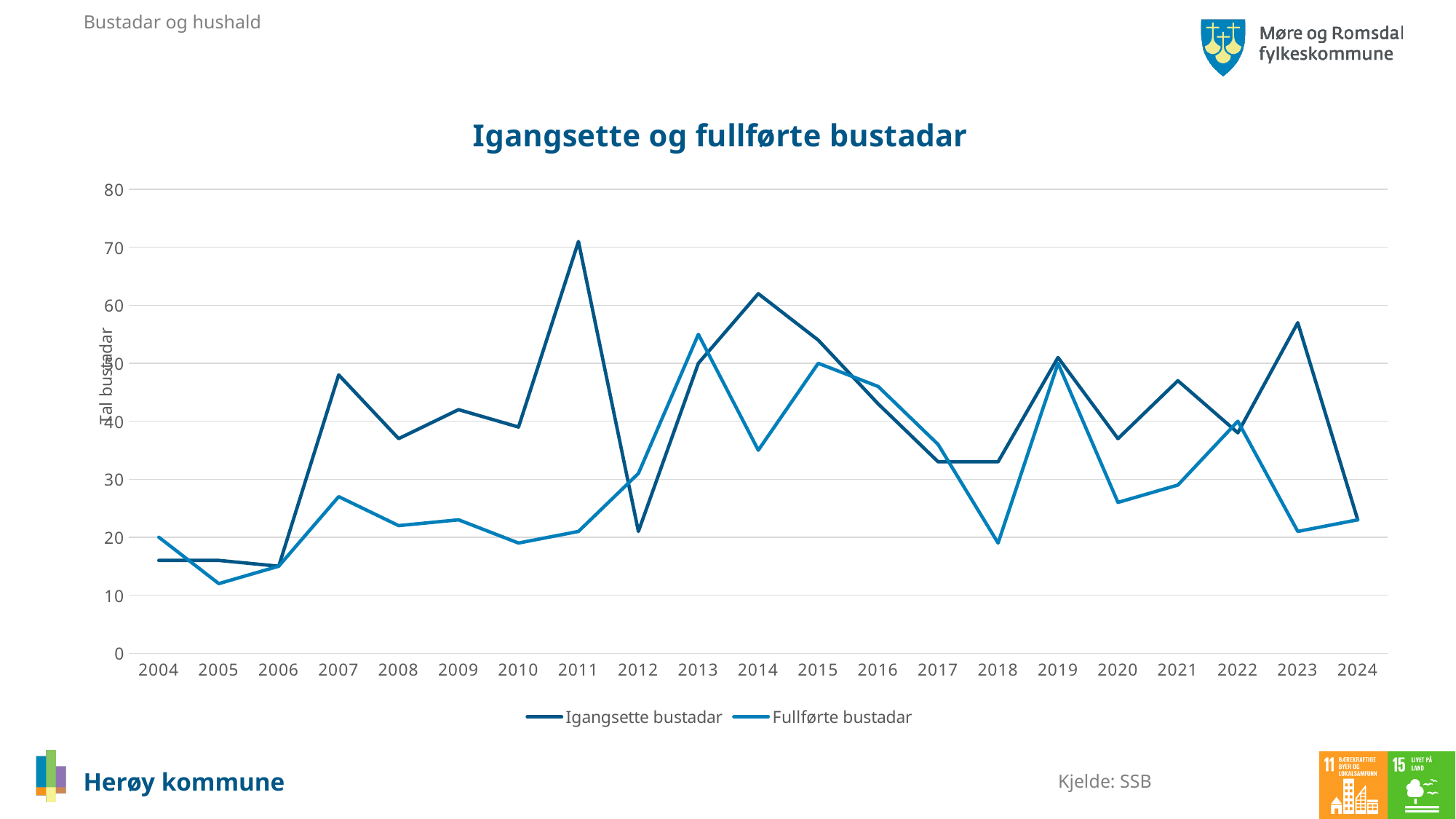
Is the value for Igangsette bustadar in 2012 greater or less than 30? less Is the value for Igangsette bustadar in 2011 greater or less than 60? greater In which year is the value for Fullførte bustadar lowest? 2005 In which year is the value for Igangsette bustadar highest? 2011 Does the value for Igangsette bustadar rise or fall from 2014 to 2017? fall Is the value for Fullførte bustadar in 2018 greater or less than 30? less In which year is the value for Fullførte bustadar highest? 2013 How many series does the legend list? 2 What kind of chart is shown on the slide? line chart How many years are shown on the x axis? 21 In 2014, which series has the larger value, Igangsette bustadar or Fullførte bustadar? Igangsette bustadar What is the value for Fullførte bustadar in 2004? 20